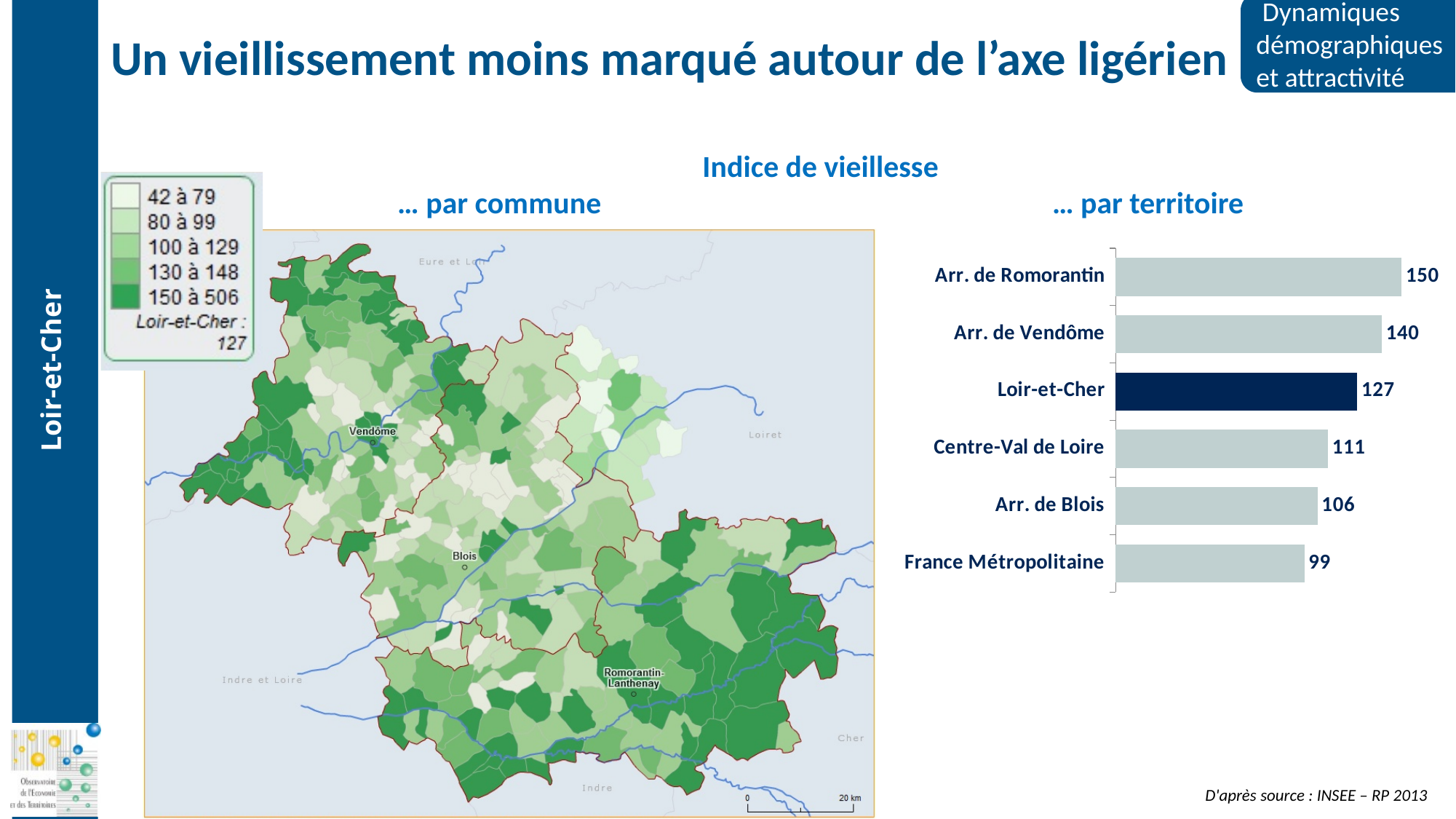
What kind of chart is the '... par territoire' chart? Bar chart In the bar chart '... par territoire', what is the difference between Arr. de Romorantin and Arr. de Vendôme? 10 In the bar chart '... par territoire', which bar is highlighted in dark blue? Loir-et-Cher In the bar chart '... par territoire', what is the value for Loir-et-Cher? 127 In the bar chart '... par territoire', which is larger: Arr. de Blois or Centre-Val de Loire? Centre-Val de Loire In the bar chart '... par territoire', what is the indice de vieillesse for Arr. de Romorantin? 150 In the bar chart '... par territoire', what is the difference between Loir-et-Cher and Centre-Val de Loire? 16 In the bar chart '... par territoire', which territory has the lowest indice de vieillesse? France Métropolitaine How many territories are shown in the bar chart '... par territoire'? 6 In the bar chart '... par territoire', which territory has the highest indice de vieillesse? Arr. de Romorantin In the bar chart '... par territoire', what is the value for France Métropolitaine? 99 In the bar chart '... par territoire', what is the value for Arr. de Blois? 106